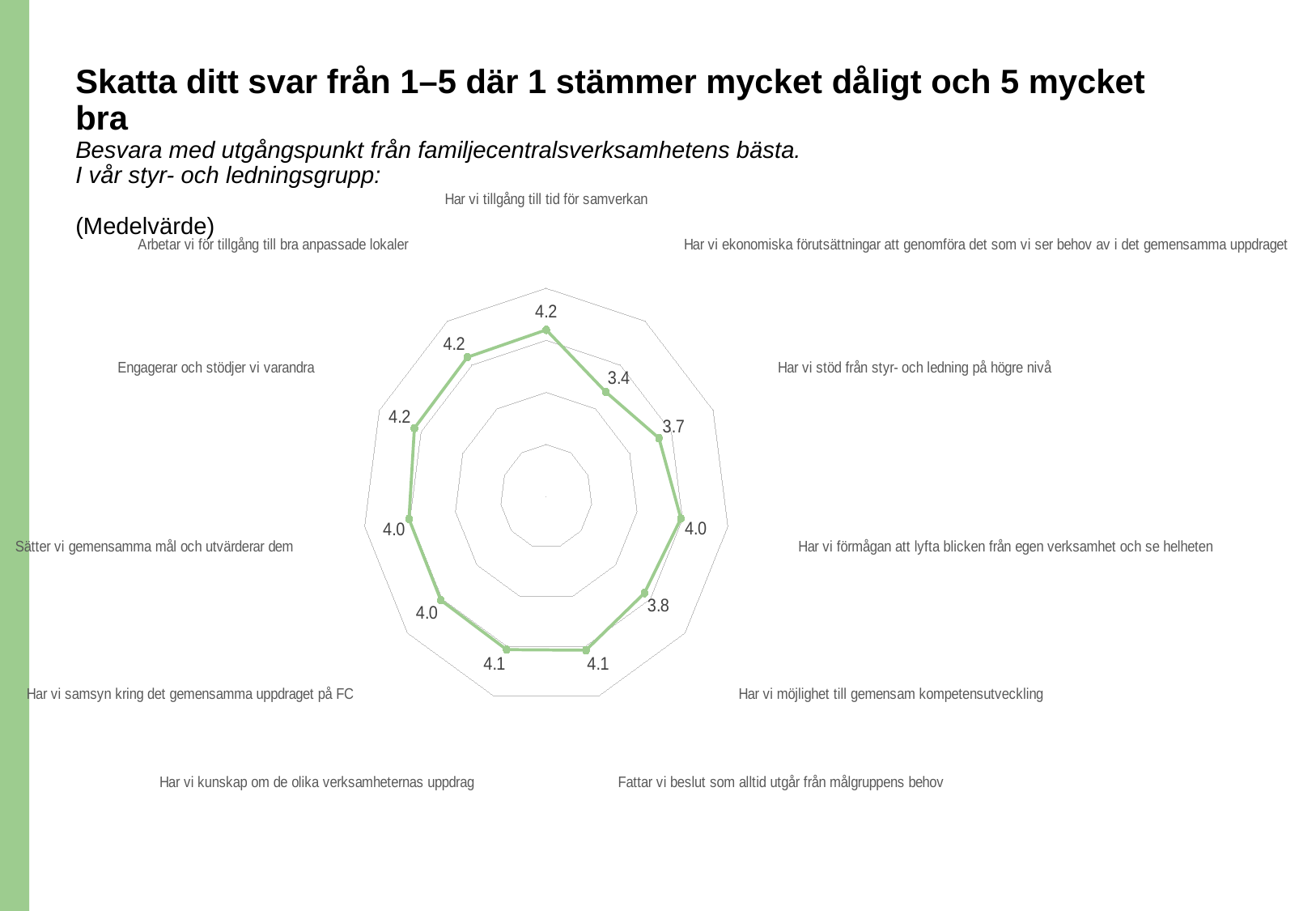
What is the difference between the value for "Har vi tillgång till tid för samverkan" and the value for "Har vi ekonomiska förutsättningar att genomföra det som vi ser behov av i det gemensamma uppdraget"? 0.8 What is the value for "Har vi möjlighet till gemensam kompetensutveckling"? 3.8 What is the value for "Fattar vi beslut som alltid utgår från målgruppens behov"? 4.1 What statistic does the chart show, according to the text in parentheses above it? Medelvärde What is the difference between the value for "Engagerar och stödjer vi varandra" and the value for "Har vi stöd från styr- och ledning på högre nivå"? 0.5 How many categories (questions) are plotted on the radar chart? 11 Which category has the lowest value on the radar chart? Har vi ekonomiska förutsättningar att genomföra det som vi ser behov av i det gemensamma uppdraget Which is larger: the value for "Har vi förmågan att lyfta blicken från egen verksamhet och se helheten" or the value for "Har vi möjlighet till gemensam kompetensutveckling"? Har vi förmågan att lyfta blicken från egen verksamhet och se helheten What is the value for "Har vi stöd från styr- och ledning på högre nivå"? 3.7 What kind of chart is shown on the slide? Radar chart What is the value for "Har vi ekonomiska förutsättningar att genomföra det som vi ser behov av i det gemensamma uppdraget"? 3.4 What is the value for "Har vi tillgång till tid för samverkan"? 4.2